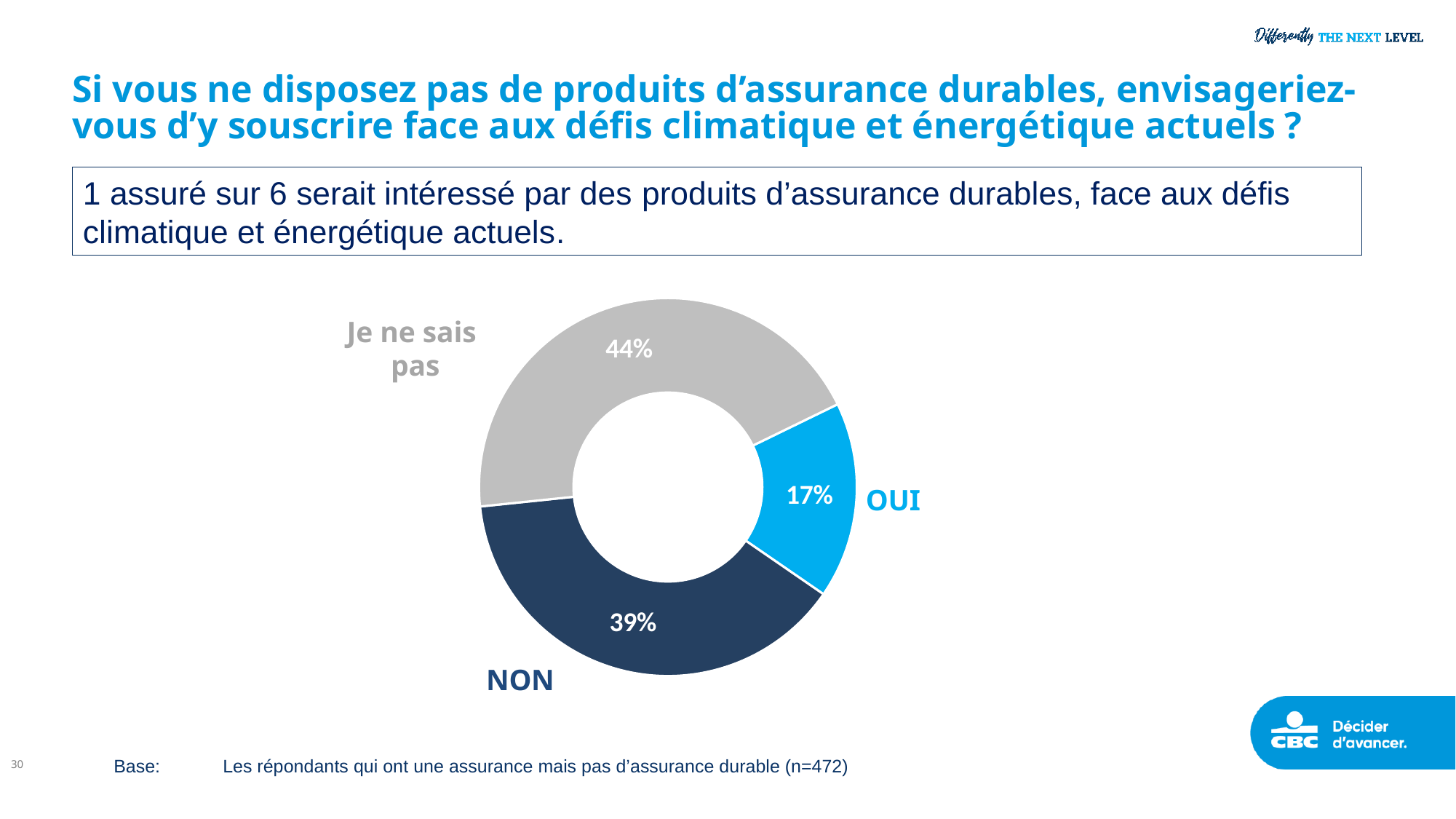
What is the difference in percentage points between NON and OUI? 22 Which is larger, the share for NON or the share for OUI? NON Which response has the largest share of the chart? Je ne sais pas What colour is the OUI segment of the chart? Light blue How many response categories are shown in the chart? 3 What is the difference in percentage points between 'Je ne sais pas' and NON? 5 What percentage of respondents answered OUI? 17% What percentage of respondents answered NON? 39% What is the base size (n) stated at the bottom of the slide? n=472 What percentage of respondents answered 'Je ne sais pas'? 44% Which response has the smallest share of the chart? OUI What kind of chart is shown on the slide? Doughnut (pie) chart